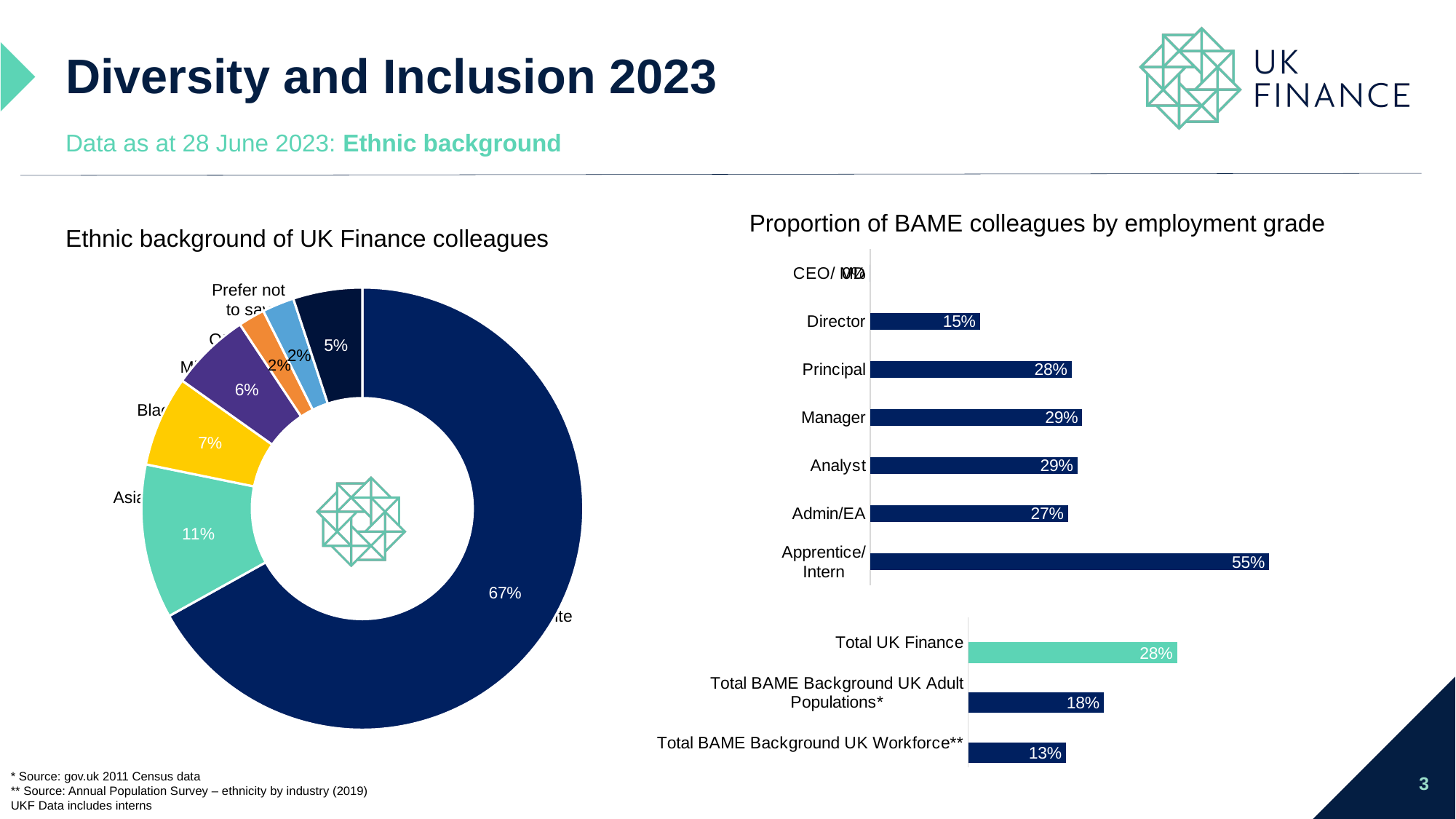
In the 'Proportion of BAME colleagues by employment grade' chart, which employment grade has the highest proportion? Apprentice/Intern In the bottom-right bar chart, what is the value for Total BAME Background UK Workforce**? 13% In the bottom-right bar chart, what is the difference between Total UK Finance and Total BAME Background UK Adult Populations*? 10% In the bottom-right bar chart, what is the value for Total UK Finance? 28% What kind of chart is 'Proportion of BAME colleagues by employment grade'? Bar chart What kind of chart is 'Ethnic background of UK Finance colleagues'? Pie (donut) chart In the 'Proportion of BAME colleagues by employment grade' chart, how many employment grades are shown? 7 In the 'Ethnic background of UK Finance colleagues' chart, what is the value of the largest slice? 67% In the 'Proportion of BAME colleagues by employment grade' chart, which is larger, Principal or Admin/EA? Principal In the 'Proportion of BAME colleagues by employment grade' chart, what is the value for Apprentice/Intern? 55% In the 'Proportion of BAME colleagues by employment grade' chart, what is the difference between Apprentice/Intern and Director? 40% In the 'Proportion of BAME colleagues by employment grade' chart, what is the value for Director? 15%